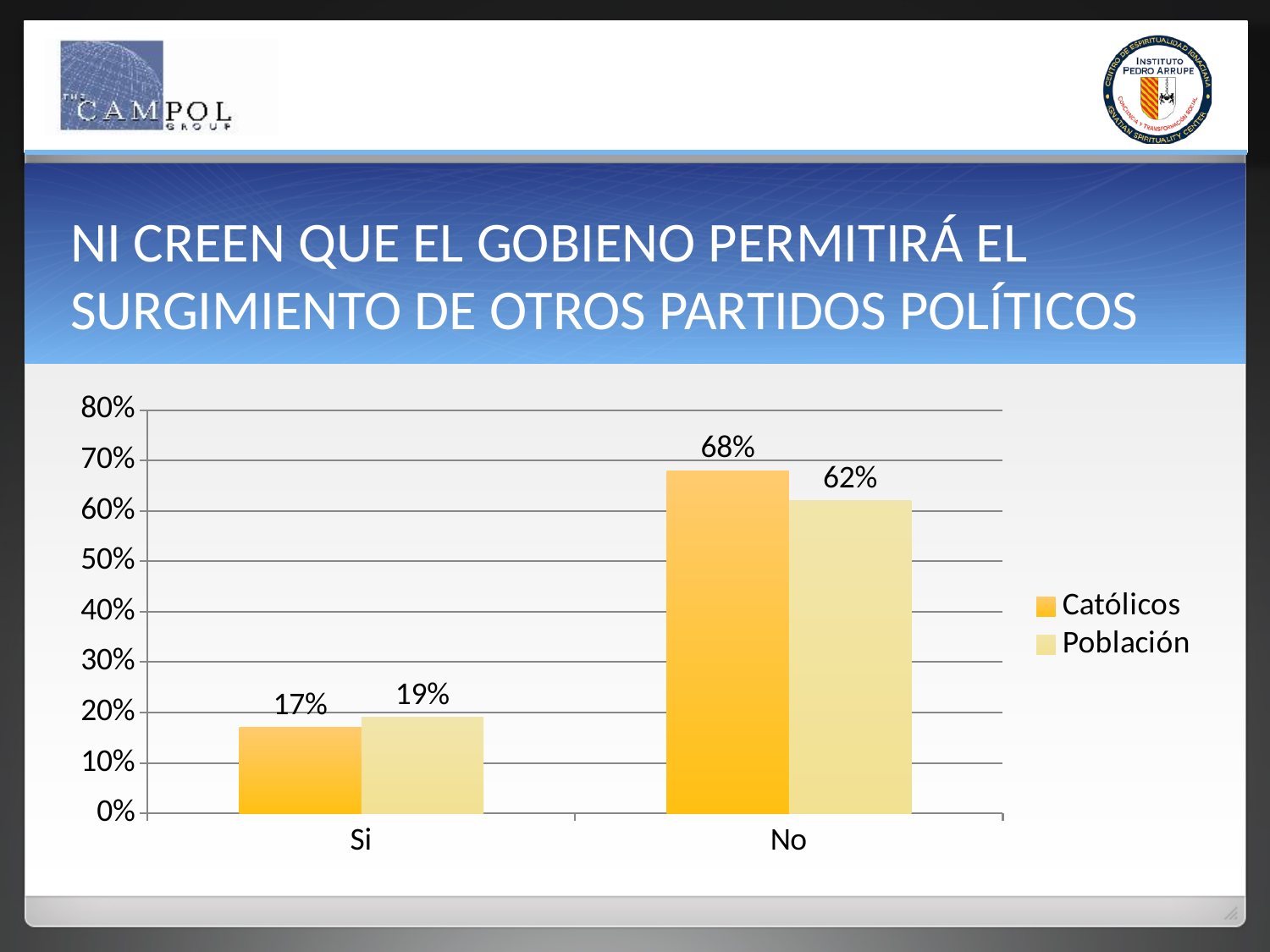
What are the two series named in the legend? Católicos and Población What is the value for Población in the No category? 62% What is the difference between Católicos and Población in the No category? 6% What kind of chart is shown on the slide? Bar chart How many categories are shown on the x axis? 2 Which category has the highest value for Católicos? No What is the value for Población in the Si category? 19% What is the value for Católicos in the No category? 68% How many series does the legend list? 2 In the Si category, which is larger, Católicos or Población? Población Which category has the lowest value for Población? Si What is the value for Católicos in the Si category? 17%